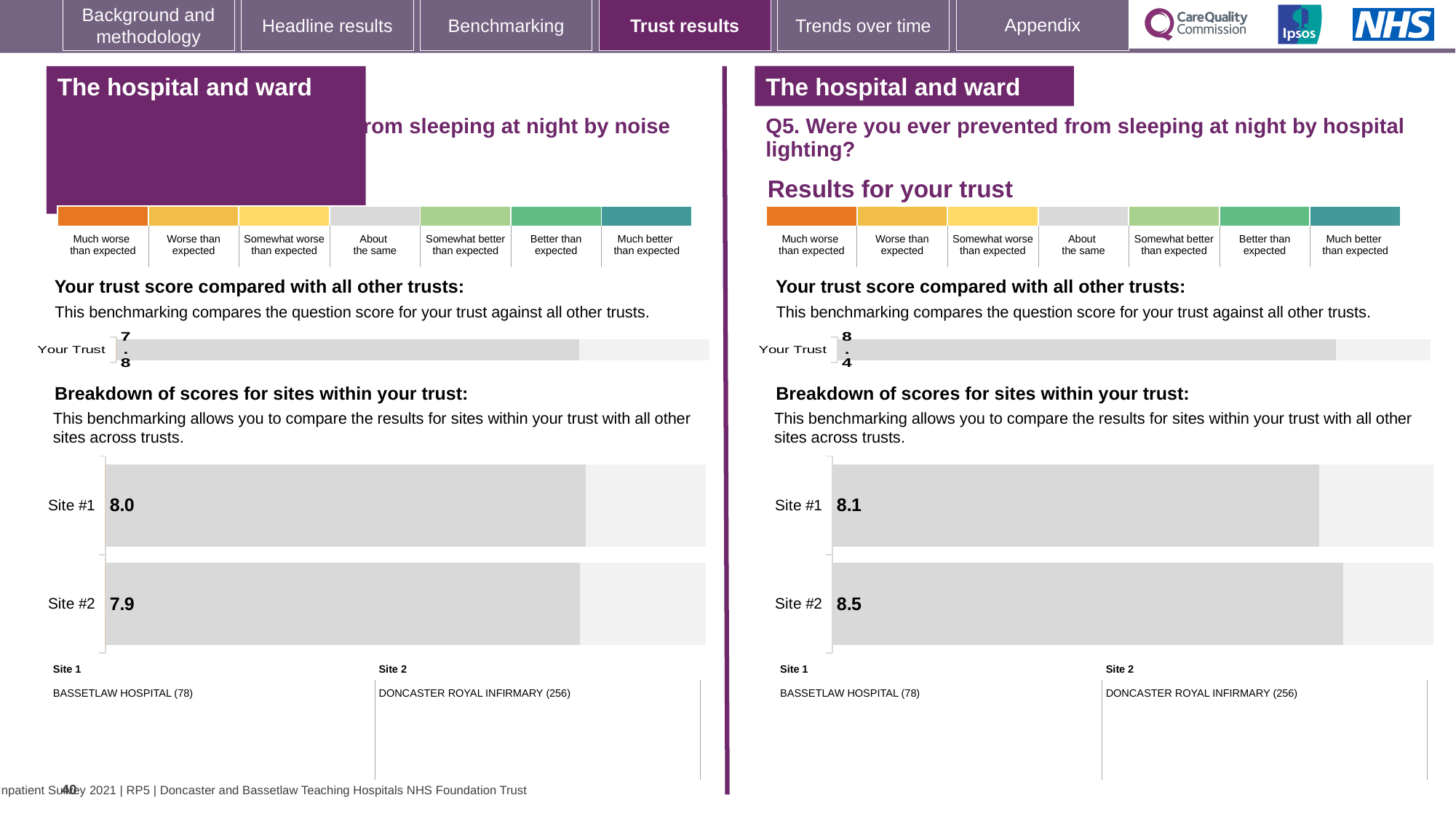
What type of chart is used for the site breakdown on the right-hand side of the slide? Bar chart On the right-hand side of the slide (Q5, hospital lighting), what is the score shown for Your Trust? 8.4 In the left-hand site breakdown chart (noise question), what is the difference between the Site #1 and Site #2 scores? 0.1 In the left-hand 'Breakdown of scores for sites within your trust' chart (noise question), what is the score for Site #2? 7.9 In the right-hand site breakdown chart (Q5, hospital lighting), which site has the higher score? Site #2 In the right-hand 'Breakdown of scores for sites within your trust' chart (Q5, hospital lighting), what is the score for Site #2? 8.5 On the left-hand side of the slide (sleeping at night by noise), what is the score shown for Your Trust? 7.8 How many sites are shown in the right-hand 'Breakdown of scores for sites within your trust' chart? 2 In the left-hand 'Breakdown of scores for sites within your trust' chart (noise question), what is the score for Site #1? 8.0 In the right-hand site breakdown chart (Q5, hospital lighting), what is the difference between the Site #2 and Site #1 scores? 0.4 In the right-hand 'Breakdown of scores for sites within your trust' chart (Q5, hospital lighting), what is the score for Site #1? 8.1 In the left-hand site breakdown chart (noise question), which site has the lower score? Site #2